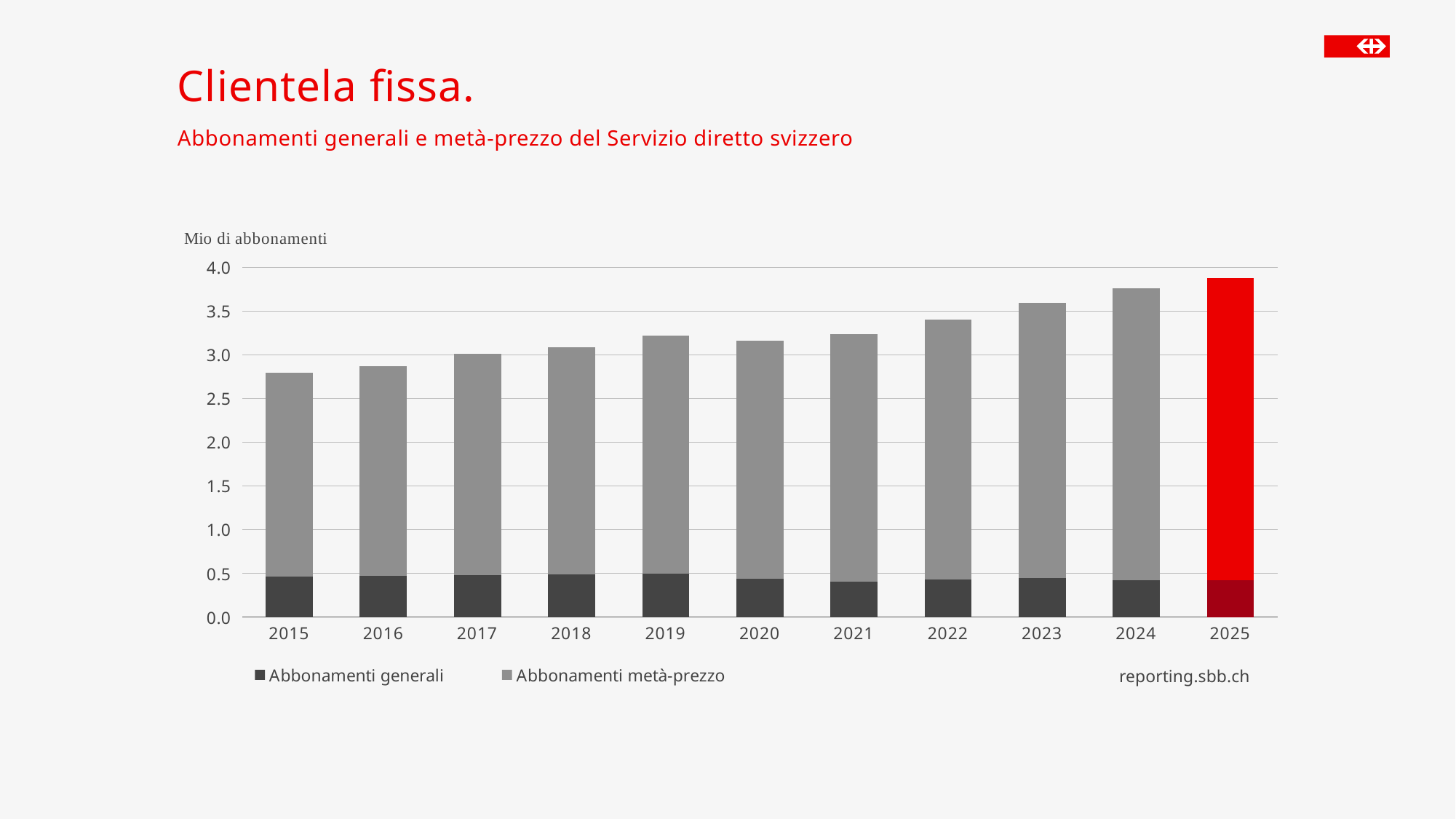
How many series does the chart's legend list? 2 Which year has the larger total, 2023 or 2024? 2024 How many years are shown on the x axis of the chart? 11 Is the total value for 2025 greater or less than 4.0? less What kind of chart is shown on the slide? Stacked bar chart Which year has the highest total number of subscriptions in the chart? 2025 Do the total values generally rise or fall from 2015 to 2025? rise Is the total value for 2015 greater or less than 2.5? greater Is the total value for 2024 greater or less than 3.5? greater What unit is given on the y axis of the chart? Mio di abbonamenti Which year has the lowest total number of subscriptions in the chart? 2015